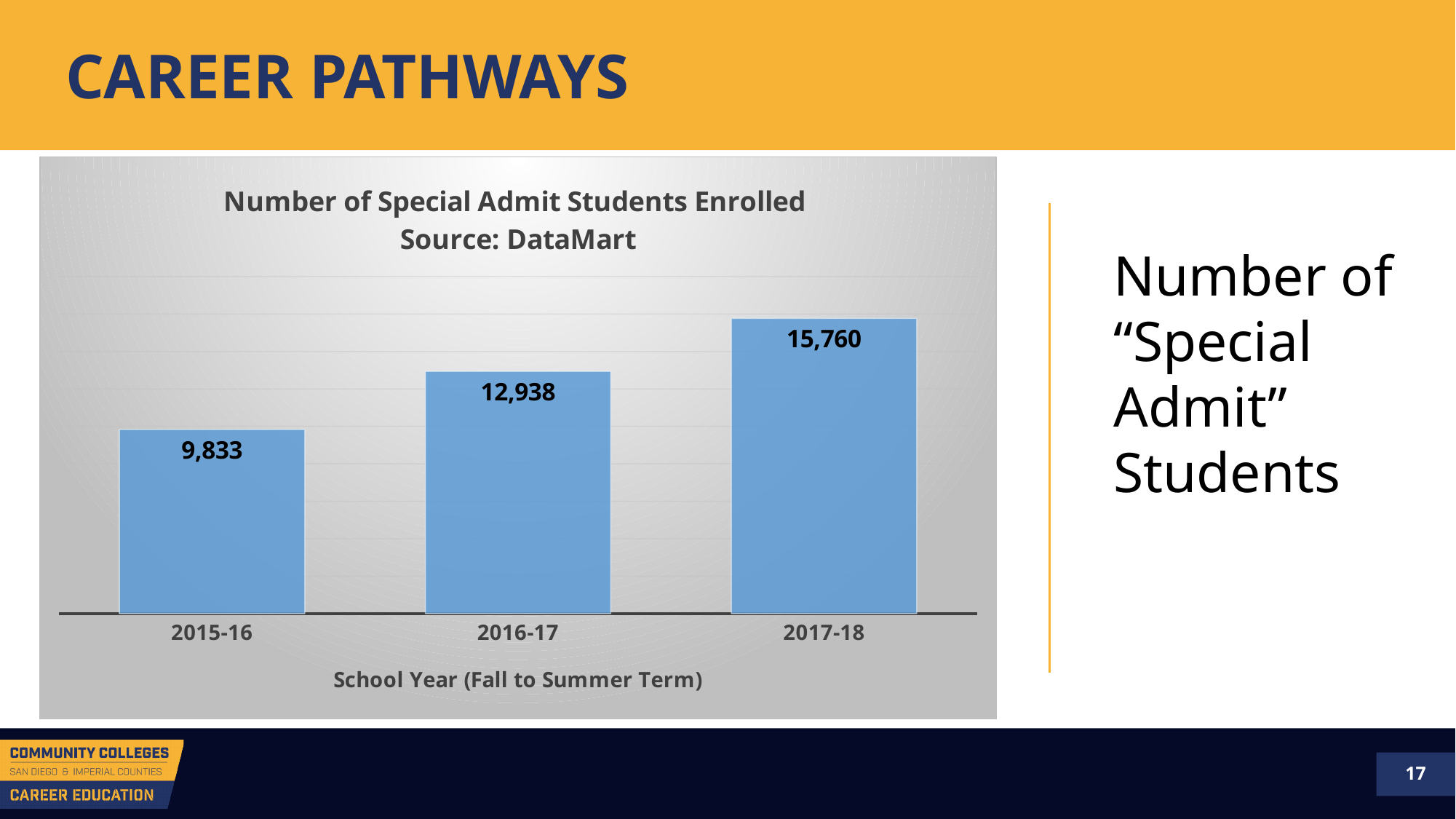
How many special admit students were enrolled in 2017-18? 15,760 Do the values rise or fall from 2015-16 to 2017-18? Rise How many school years are shown on the chart? 3 What is the difference in special admit students enrolled between 2016-17 and 2015-16? 3,105 How many special admit students were enrolled in 2016-17? 12,938 How many special admit students were enrolled in 2015-16? 9,833 What is the x-axis label of the chart? School Year (Fall to Summer Term) What is the difference in special admit students enrolled between 2017-18 and 2016-17? 2,822 What kind of chart is shown on the slide? Bar chart Which school year had the lowest number of special admit students enrolled? 2015-16 Which school year had more special admit students enrolled, 2015-16 or 2016-17? 2016-17 Which school year had the highest number of special admit students enrolled? 2017-18